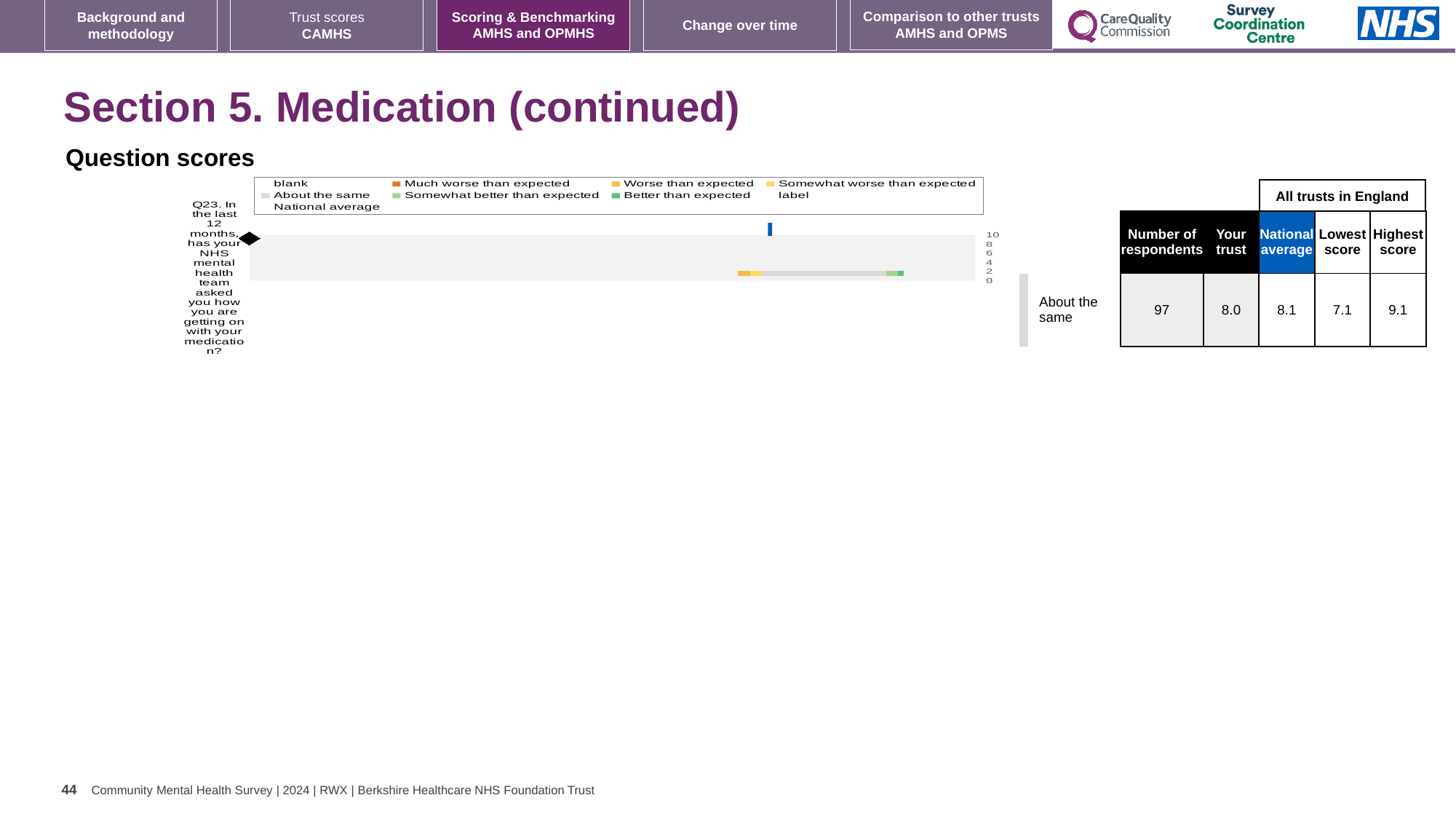
Which survey question is plotted in the chart? Q23. In the last 12 months, has your NHS mental health team asked you how you are getting on with your medication? In the table beside the chart, what is the highest score among all trusts in England for Q23? 9.1 In the table beside the chart, what is the 'Your trust' score for Q23? 8.0 How many survey questions are plotted as categories in the chart? 1 What is the difference between the highest score and the lowest score for Q23 in the table beside the chart? 2.0 In the table beside the chart, what is the national average score for Q23? 8.1 How many respondents answered Q23 according to the table beside the chart? 97 Which is larger for Q23, the 'Your trust' score or the national average? National average What is the highest value shown on the chart's numeric axis? 10 What kind of chart is shown under 'Question scores'? bar chart In the table beside the chart, what is the lowest score among all trusts in England for Q23? 7.1 How many entries does the chart legend list? 9